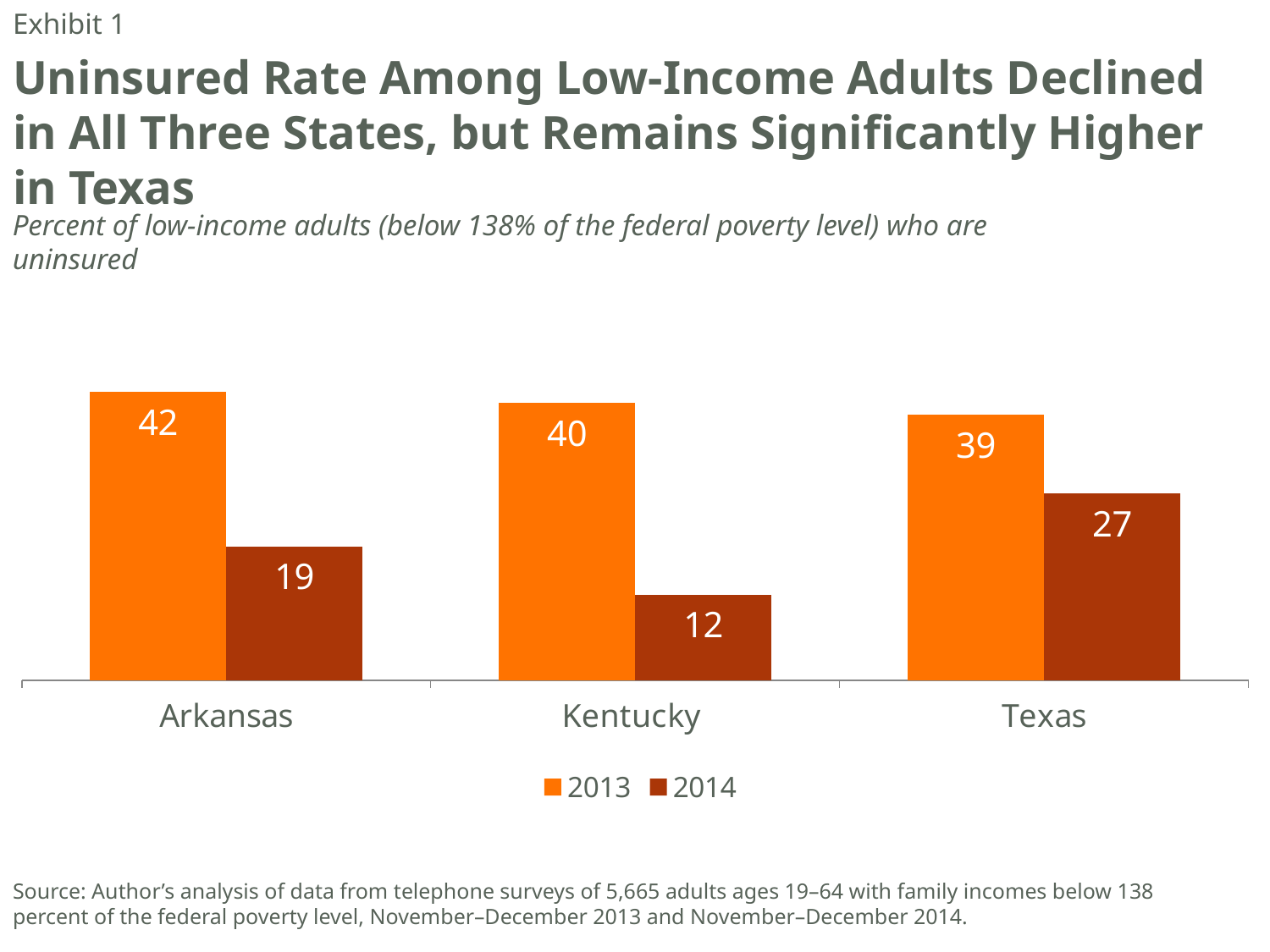
Which is larger: the 2014 uninsured rate in Arkansas or the 2014 uninsured rate in Texas? Texas What was the uninsured rate for low-income adults in Arkansas in 2013? 42 Which state had the lowest uninsured rate in 2014? Kentucky What was the uninsured rate for low-income adults in Kentucky in 2014? 12 What is the difference between the 2013 and 2014 uninsured rates in Texas? 12 How many states are shown on the chart? 3 What kind of chart is shown on the slide? Bar chart What was the uninsured rate for low-income adults in Texas in 2014? 27 How many series does the legend list? 2 Which state had the highest uninsured rate in 2013? Arkansas Which state had the highest uninsured rate in 2014? Texas By how many percentage points did the uninsured rate in Kentucky fall from 2013 to 2014? 28